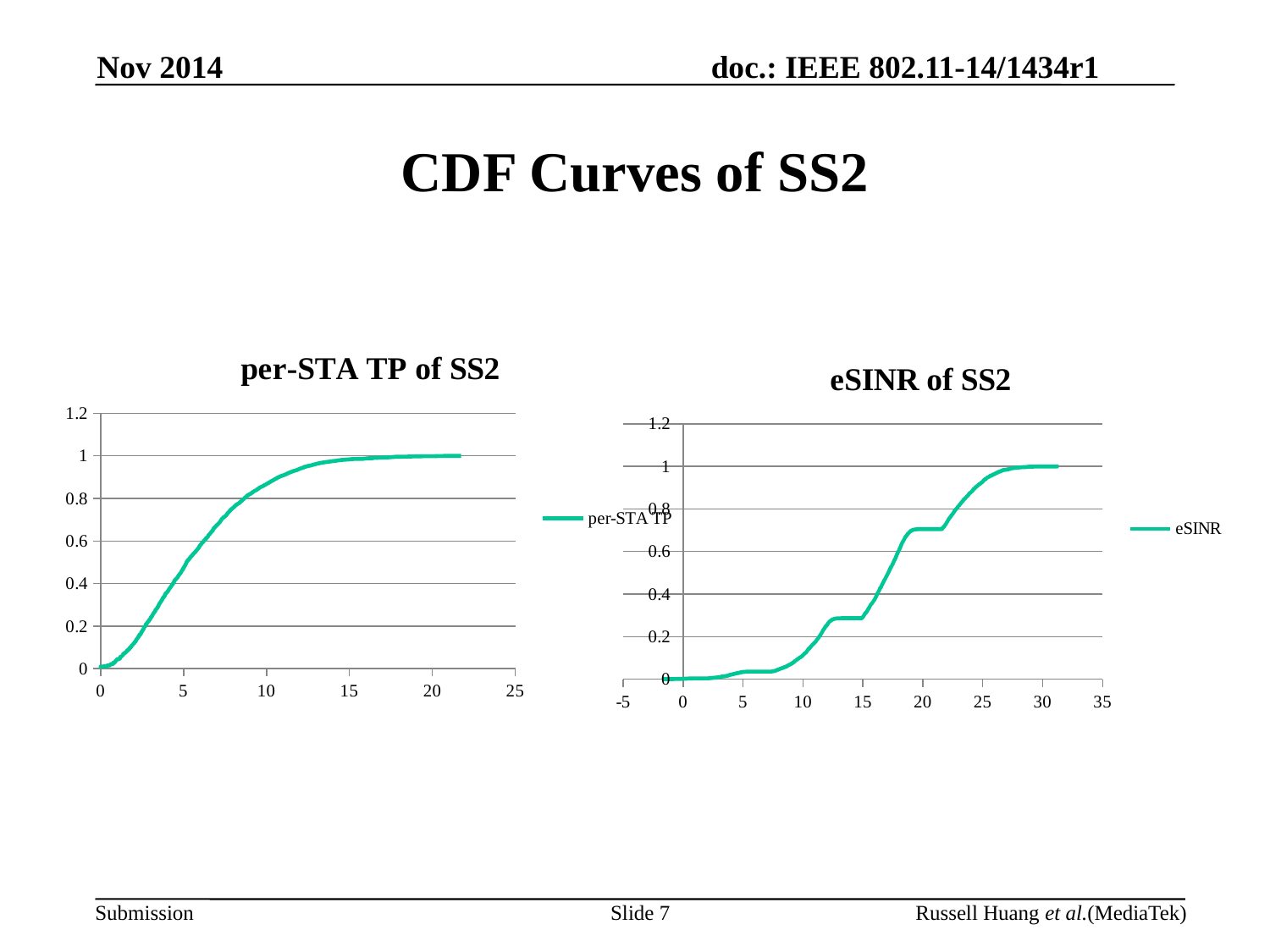
In the 'per-STA TP of SS2' chart, is the value at x = 5 greater or less than 0.4? greater How many series does the legend of the 'eSINR of SS2' chart list? 1 What is the legend entry shown for the series in the 'eSINR of SS2' chart? eSINR What is the highest value shown on the y axis of the 'per-STA TP of SS2' chart? 1.2 In the 'per-STA TP of SS2' chart, is the value at x = 10 greater or less than 0.8? greater In the 'eSINR of SS2' chart, do the values rise or fall as x increases? rise In the 'eSINR of SS2' chart, is the value at x = 20 greater or less than 0.6? greater What kind of chart is the 'per-STA TP of SS2' chart? line chart What kind of chart is the 'eSINR of SS2' chart? line chart How many series does the legend of the 'per-STA TP of SS2' chart list? 1 In the 'per-STA TP of SS2' chart, do the values rise or fall as x increases? rise